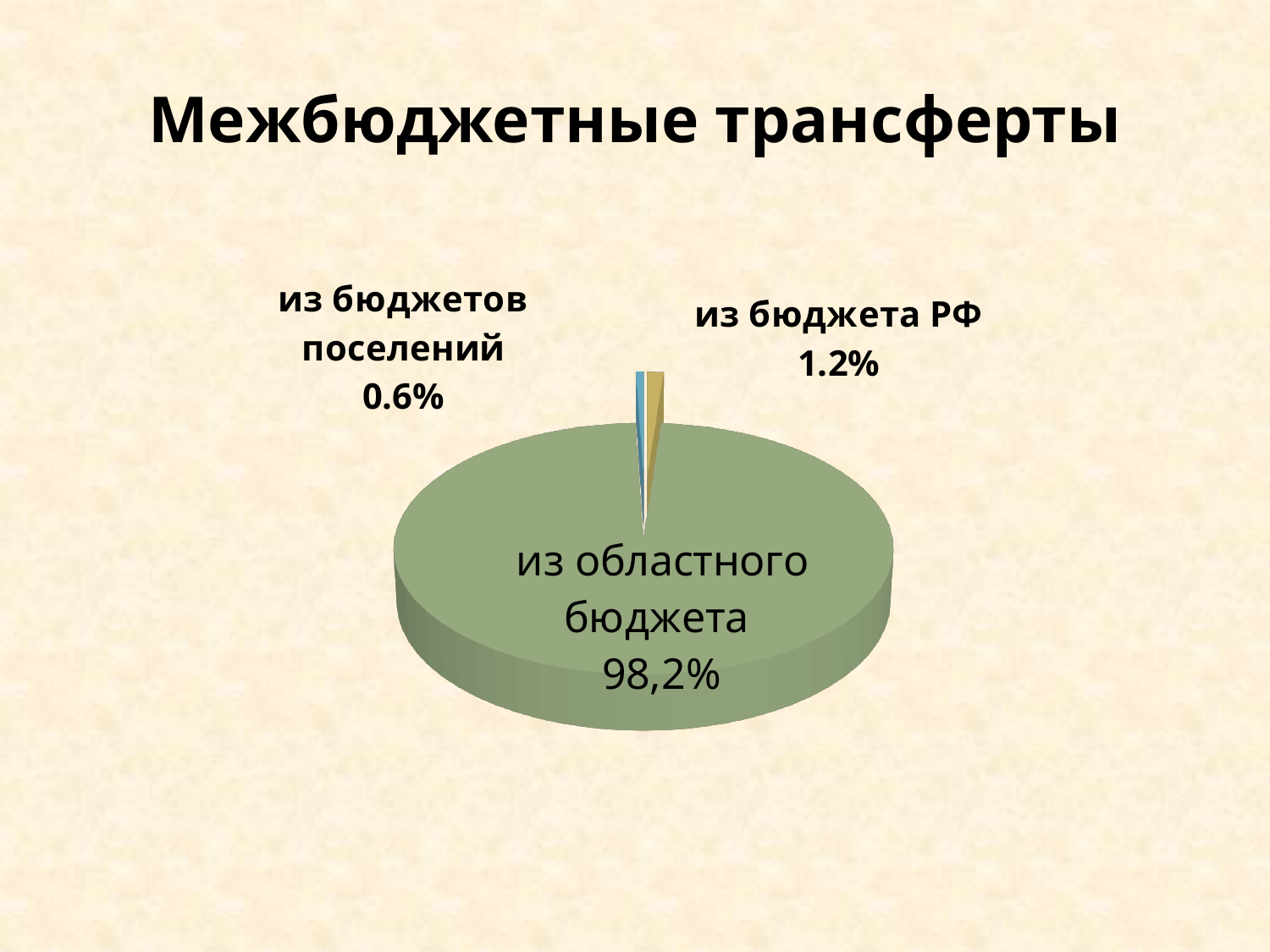
What share of the pie is labelled "из бюджета РФ"? 1.2% What is the title of the chart on the slide? Межбюджетные трансферты Which slice of the pie chart is the largest? из областного бюджета What share of the pie is labelled "из областного бюджета"? 98,2% By how many percentage points does the share for "из областного бюджета" exceed the share for "из бюджета РФ"? 97 What kind of chart is shown on the slide? pie chart What colour is the largest slice of the pie chart? green Which slice of the pie chart is the smallest? из бюджетов поселений By how many percentage points does the share for "из бюджета РФ" exceed the share for "из бюджетов поселений"? 0.6 What share of the pie is labelled "из бюджетов поселений"? 0.6% How many slices does the pie chart have? 3 Which is larger: the share for "из бюджета РФ" or the share for "из бюджетов поселений"? из бюджета РФ